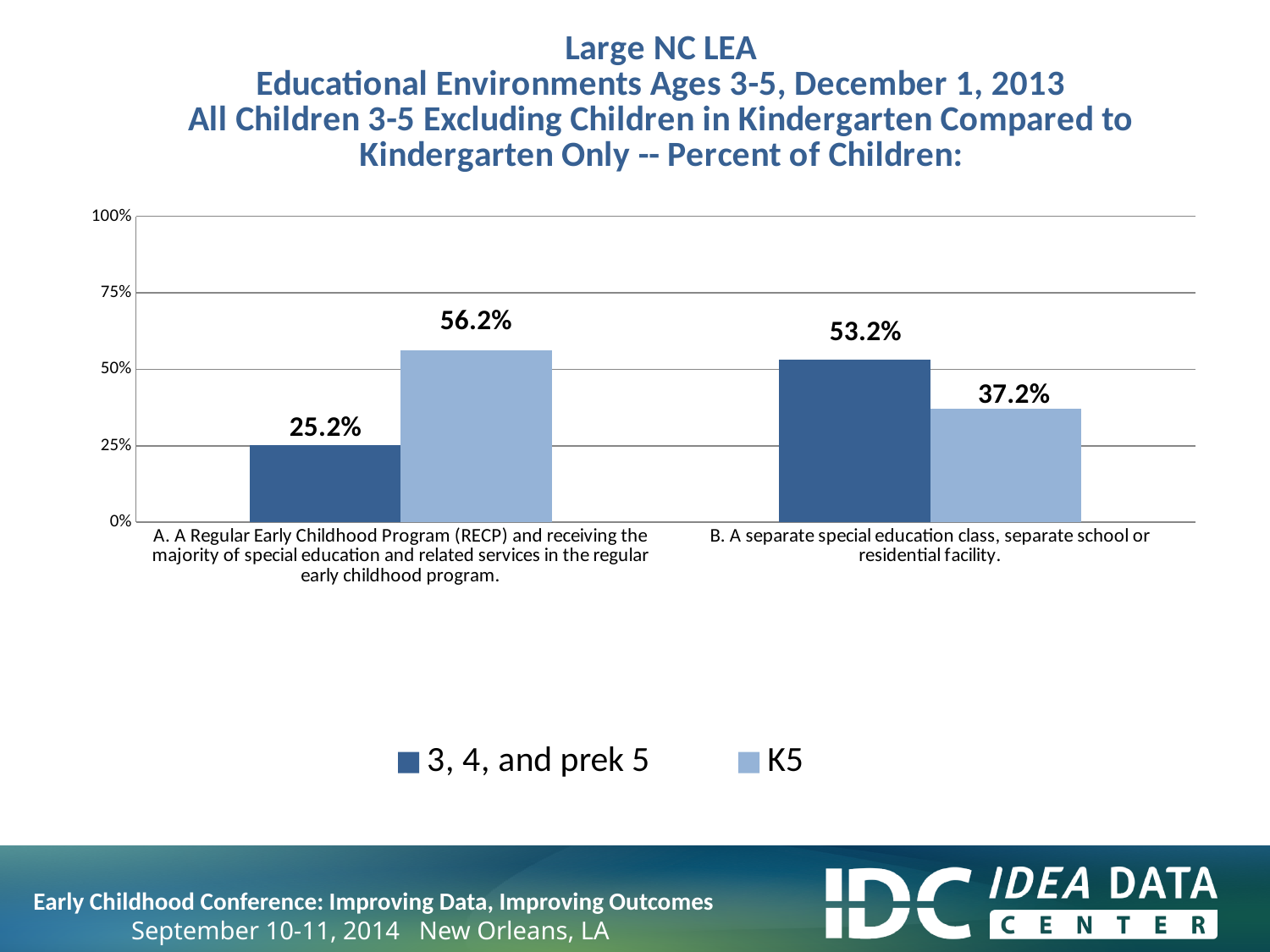
What is the difference between the '3, 4, and prek 5' value and the K5 value in category B? 16.0 percentage points What is the difference between the K5 value and the '3, 4, and prek 5' value in category A? 31.0 percentage points How many series does the legend list? 2 How many categories are shown on the x axis? 2 What is the value for the '3, 4, and prek 5' series in category A (Regular Early Childhood Program)? 25.2% What kind of chart is shown on the slide? Bar chart Which bar has the lowest value on the chart? 3, 4, and prek 5 in category A (25.2%) What is the value for the '3, 4, and prek 5' series in category B (separate special education class, separate school or residential facility)? 53.2% What is the value for the K5 series in category A (Regular Early Childhood Program)? 56.2% In category B, which series has the larger value, '3, 4, and prek 5' or K5? 3, 4, and prek 5 Which bar has the highest value on the chart? K5 in category A (56.2%) What is the value for the K5 series in category B (separate special education class, separate school or residential facility)? 37.2%